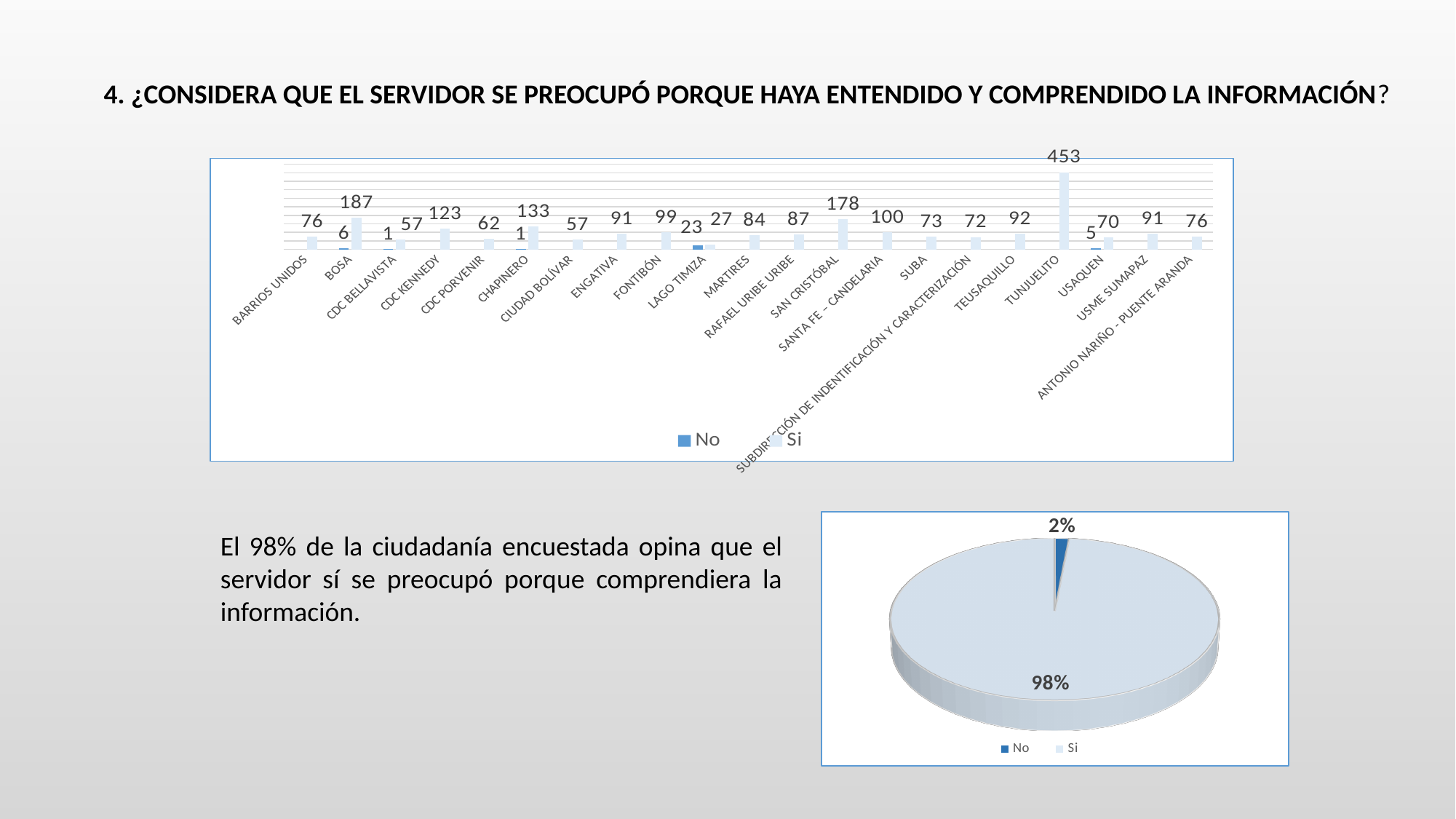
In the top bar chart, what is the value of the Si series for TUNJUELITO? 453 In the top bar chart, what is the value of the Si series for SAN CRISTÓBAL? 178 In the top bar chart, what is the difference between the Si values for BOSA and CDC KENNEDY? 64 What kind of chart is the chart at the bottom right of the slide? Pie chart In the top bar chart, what is the value of the No series for LAGO TIMIZA? 23 What kind of chart is the chart at the top of the slide? Bar chart In the top bar chart, how many series does the legend list? 2 In the bottom-right pie chart, what share does the Si slice represent? 98% In the top bar chart, which is larger: the Si value for ENGATIVA or the Si value for FONTIBÓN? FONTIBÓN In the top bar chart, how many categories are shown on the x axis? 21 In the top bar chart, which category has the highest Si value? TUNJUELITO In the bottom-right pie chart, what share does the No slice represent? 2%